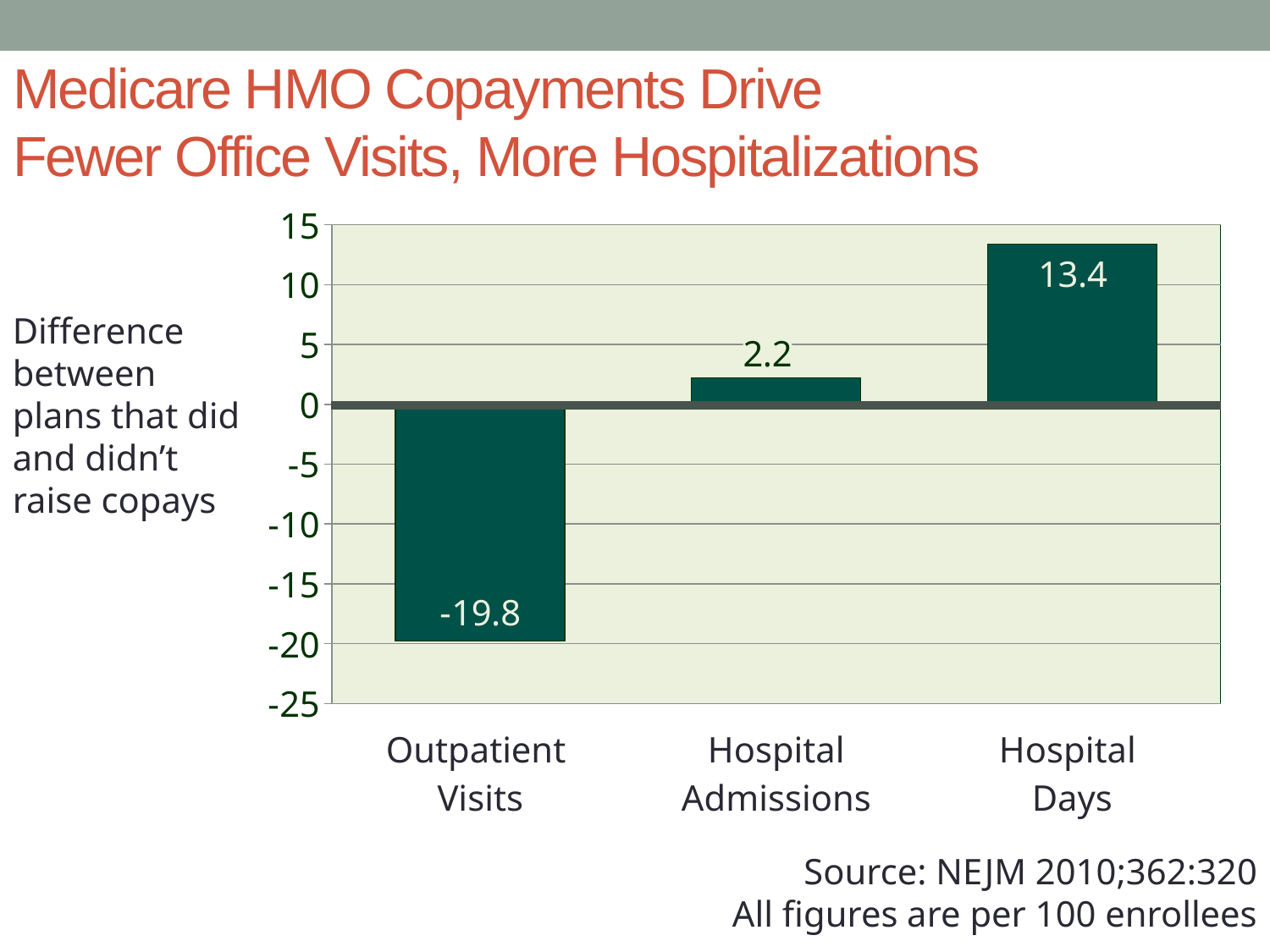
What kind of chart is shown on the slide? bar chart What is the difference between the values for Hospital Days and Hospital Admissions? 11.2 Do the values rise or fall from Outpatient Visits to Hospital Days? rise Which is larger, the value for Hospital Admissions or the value for Hospital Days? Hospital Days What is the value for Outpatient Visits? -19.8 Which category has the highest value? Hospital Days What is the value for Hospital Days? 13.4 What is the value for Hospital Admissions? 2.2 According to the note below the chart, what unit are all figures expressed in? per 100 enrollees Which category has the lowest value? Outpatient Visits How many categories are shown on the x axis? 3 Is the value for Hospital Days greater or less than 10? greater